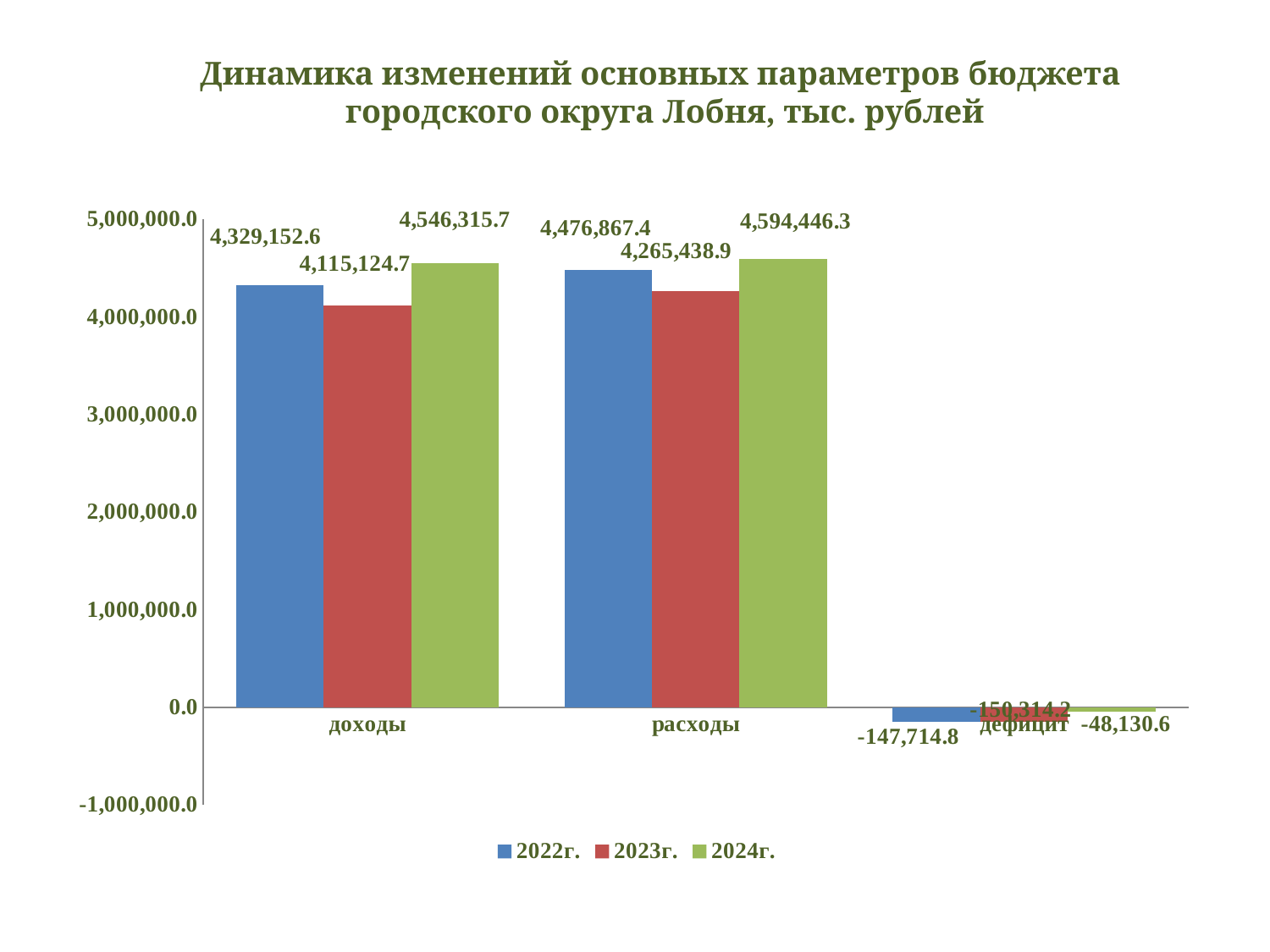
How many categories are shown on the x axis? 3 How many series does the legend list? 3 What is the value for доходы in 2023г.? 4,115,124.7 What is the value for доходы in 2022г.? 4,329,152.6 Which is larger: расходы in 2022г. or доходы in 2022г.? расходы in 2022г. What is the value for дефицит in 2022г.? -147,714.8 What is the value for расходы in 2024г.? 4,594,446.3 Which year has the lowest value for доходы? 2023г. Is the value for доходы in 2023г. greater or less than 4,000,000.0? greater What is the difference between доходы in 2024г. and доходы in 2022г.? 217,163.1 What type of chart is shown on the slide? bar chart Which year has the highest value for расходы? 2024г.